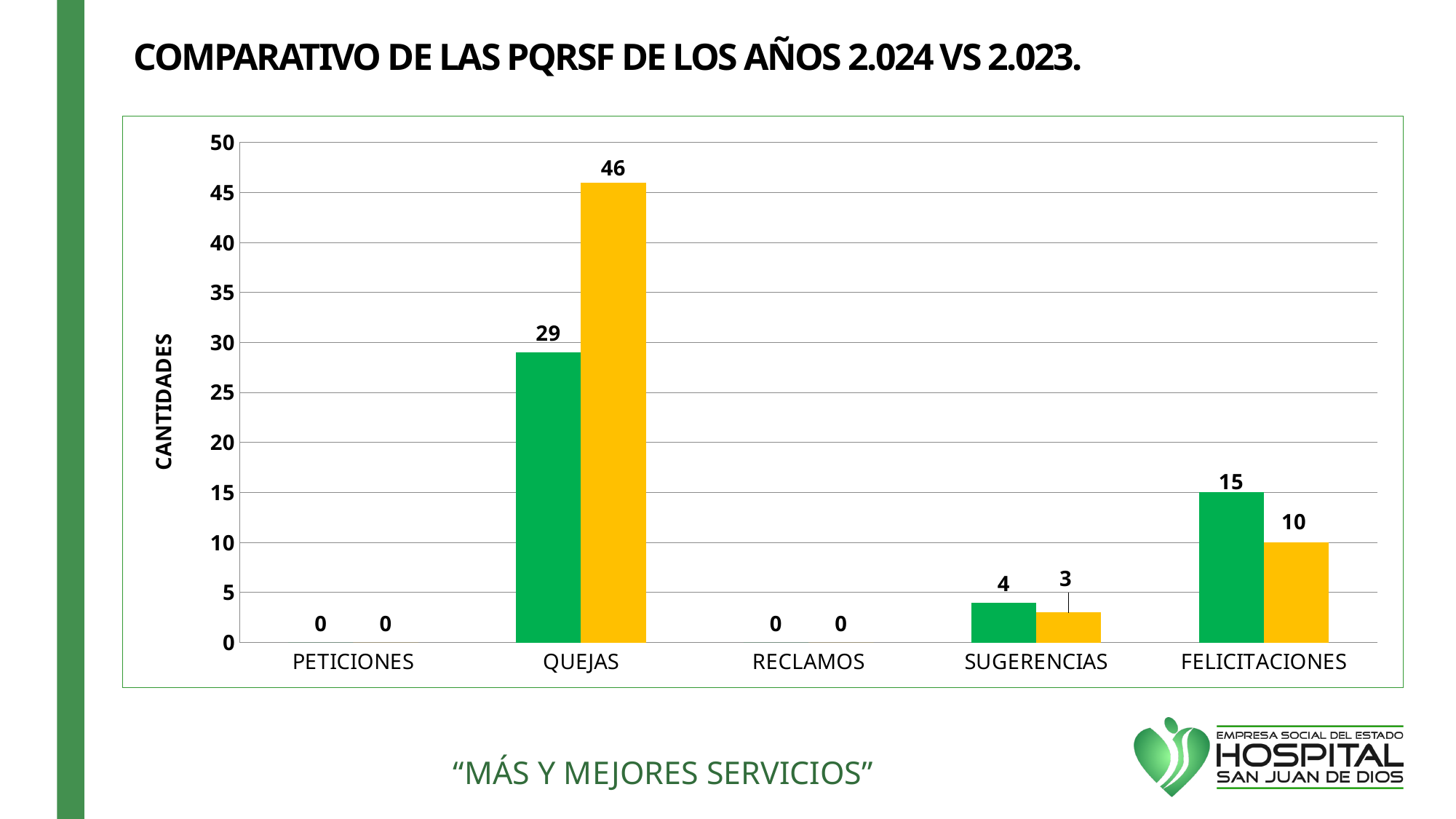
What is the value of the yellow bar for SUGERENCIAS? 3 What kind of chart is shown on the slide? bar chart What is the value of the yellow bar for QUEJAS? 46 What is the difference between the green bar and the yellow bar for FELICITACIONES? 5 What is the difference between the yellow bar and the green bar for QUEJAS? 17 What is the value of the green bar for FELICITACIONES? 15 Which category has the highest value in the chart? QUEJAS How many categories are shown on the x axis of the chart? 5 What is the value of the green bar for QUEJAS? 29 What value is shown for both bars of PETICIONES and RECLAMOS? 0 What is the label of the vertical axis of the chart? CANTIDADES Which is larger for SUGERENCIAS, the green bar or the yellow bar? the green bar